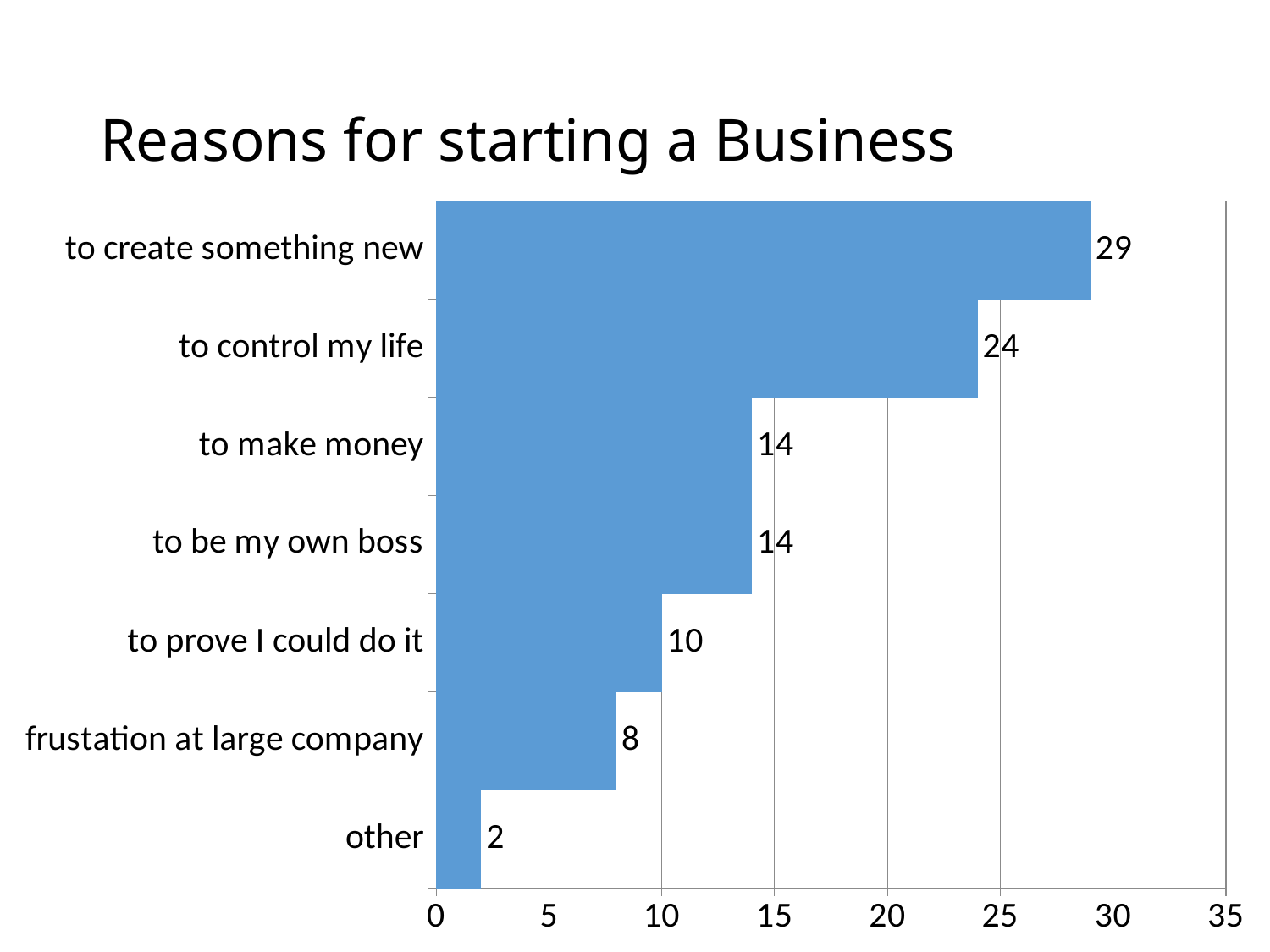
What is the value for "to control my life"? 24 What kind of chart is shown on the slide? bar chart Is the value for "to control my life" greater or less than 20? greater How many categories are shown in the chart? 7 What is the value for "to create something new"? 29 What is the difference between the values for "to create something new" and "to control my life"? 5 What is the value for "frustation at large company"? 8 Which category has the lowest value? other What is the value for "to prove I could do it"? 10 Which is larger, the value for "to control my life" or the value for "to prove I could do it"? to control my life What is the difference between the values for "to make money" and "other"? 12 Which category has the highest value? to create something new